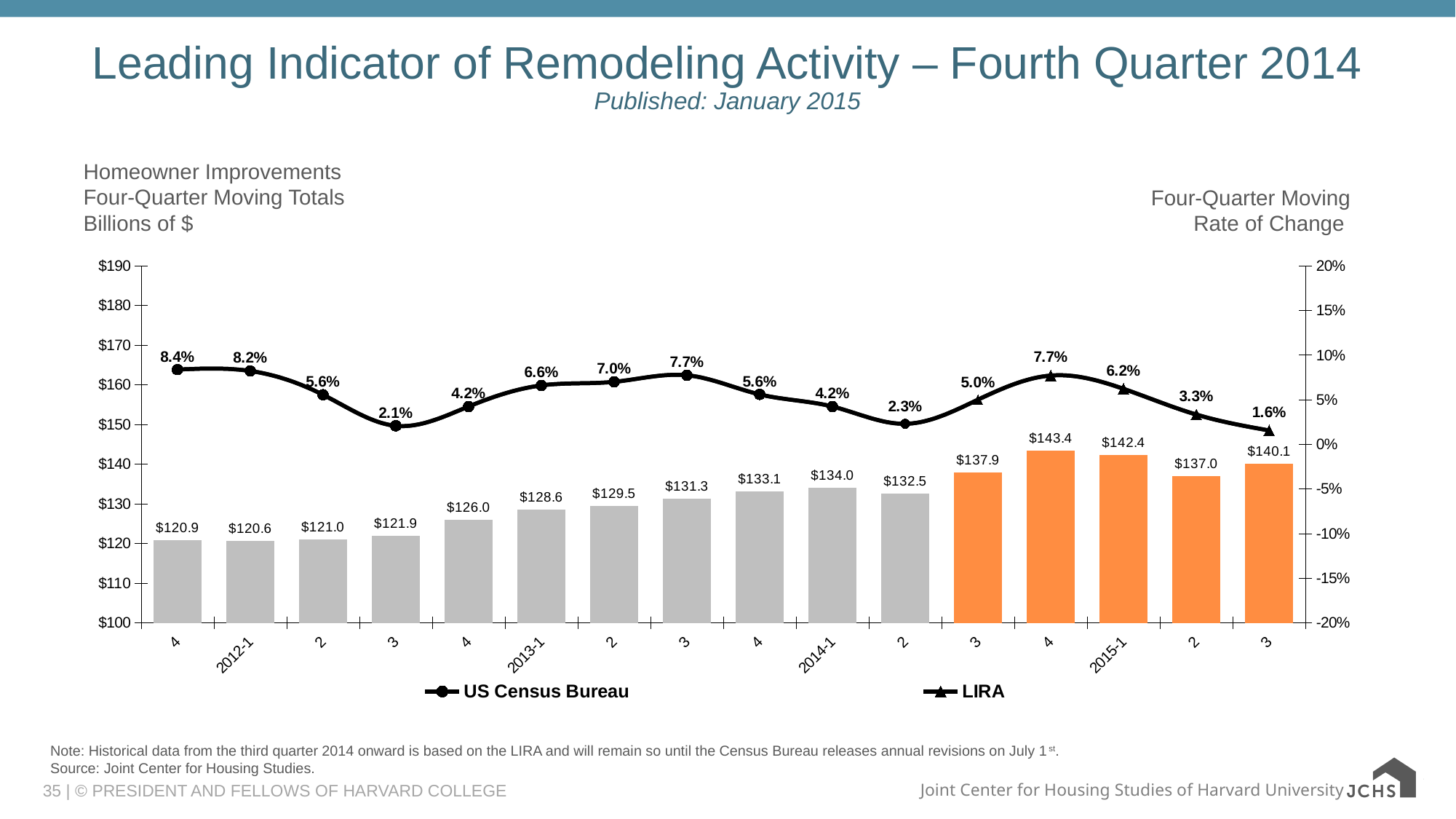
How many series does the legend list? 2 Which quarter has the highest four-quarter moving total? 2014 quarter 4 ($143.4) What is the four-quarter moving total for 2014-1? $134.0 What is the four-quarter moving rate of change for 2013-1? 6.6% What is the four-quarter moving total for 2015-1? $142.4 Which is larger, the rate of change for 2012-1 or for 2013-1? 2012-1 (8.2%) What is the four-quarter moving rate of change for the last quarter shown (2015 quarter 3)? 1.6% What are the two series named in the legend? US Census Bureau and LIRA What is the difference between the four-quarter moving totals for 2015-1 and 2014-1? $8.4 What kind of chart is shown on the slide? Combined bar and line chart How many bars are plotted in the chart? 16 Which quarter has the lowest four-quarter moving total? 2012-1 ($120.6)